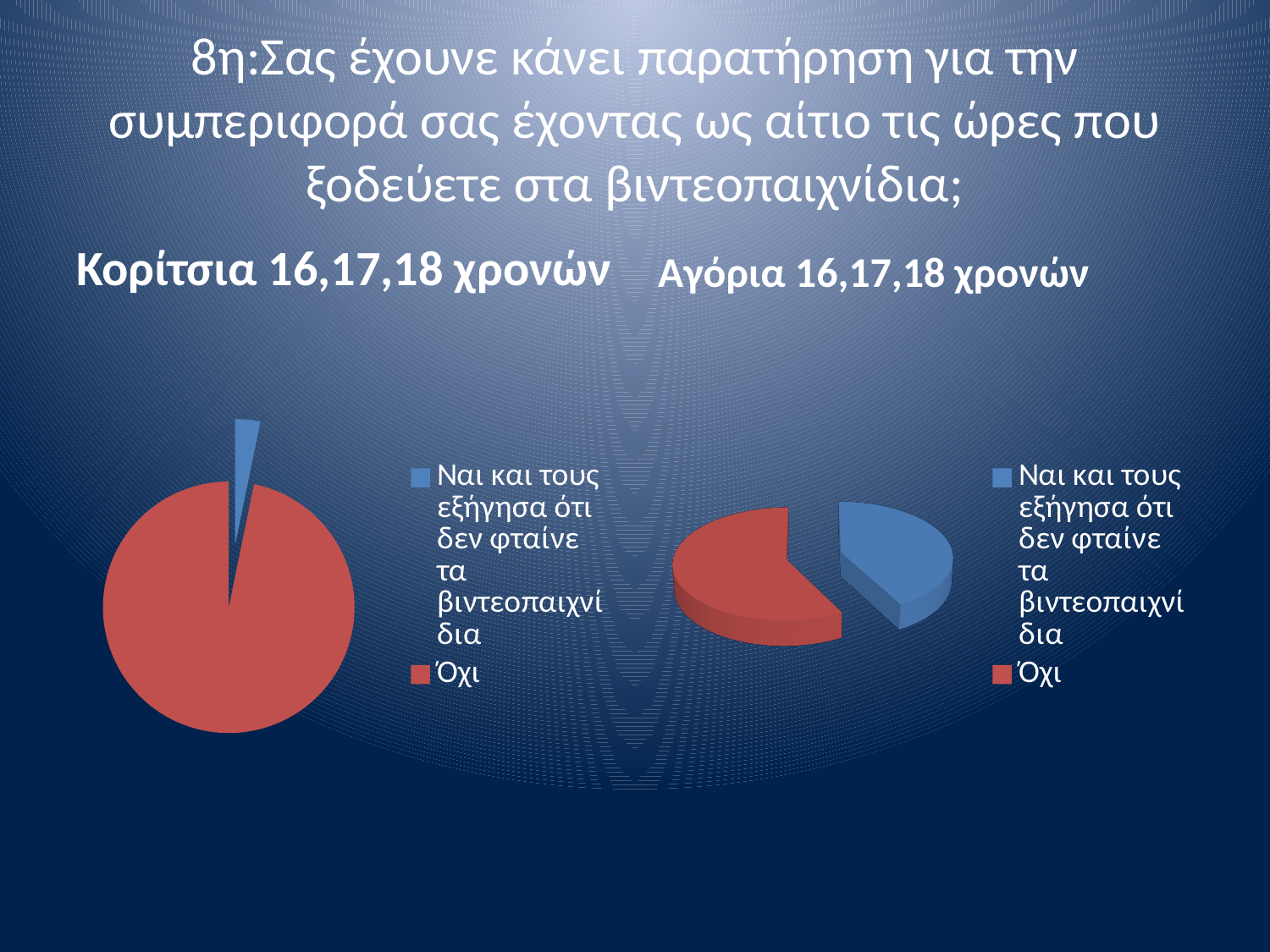
In the chart titled "Κορίτσια 16,17,18 χρονών", which category has the smallest slice? Ναι και τους εξήγησα ότι δεν φταίνε τα βιντεοπαιχνίδια In the chart titled "Κορίτσια 16,17,18 χρονών", what colour is the slice for "Όχι"? red In the chart titled "Αγόρια 16,17,18 χρονών", which category has the largest slice? Όχι In the chart titled "Κορίτσια 16,17,18 χρονών", how many slices does the pie have? 2 In the chart titled "Κορίτσια 16,17,18 χρονών", how many entries does the legend list? 2 In the chart titled "Αγόρια 16,17,18 χρονών", which category has the smallest slice? Ναι και τους εξήγησα ότι δεν φταίνε τα βιντεοπαιχνίδια In the chart titled "Αγόρια 16,17,18 χρονών", what colour is the slice for "Ναι και τους εξήγησα ότι δεν φταίνε τα βιντεοπαιχνίδια"? blue In the chart titled "Κορίτσια 16,17,18 χρονών", which category has the largest slice? Όχι What kind of chart is the chart titled "Κορίτσια 16,17,18 χρονών"? pie chart What kind of chart is the chart titled "Αγόρια 16,17,18 χρονών"? pie chart In the chart titled "Αγόρια 16,17,18 χρονών", which slice is larger: "Όχι" or "Ναι και τους εξήγησα ότι δεν φταίνε τα βιντεοπαιχνίδια"? Όχι In the chart titled "Αγόρια 16,17,18 χρονών", how many slices does the pie have? 2